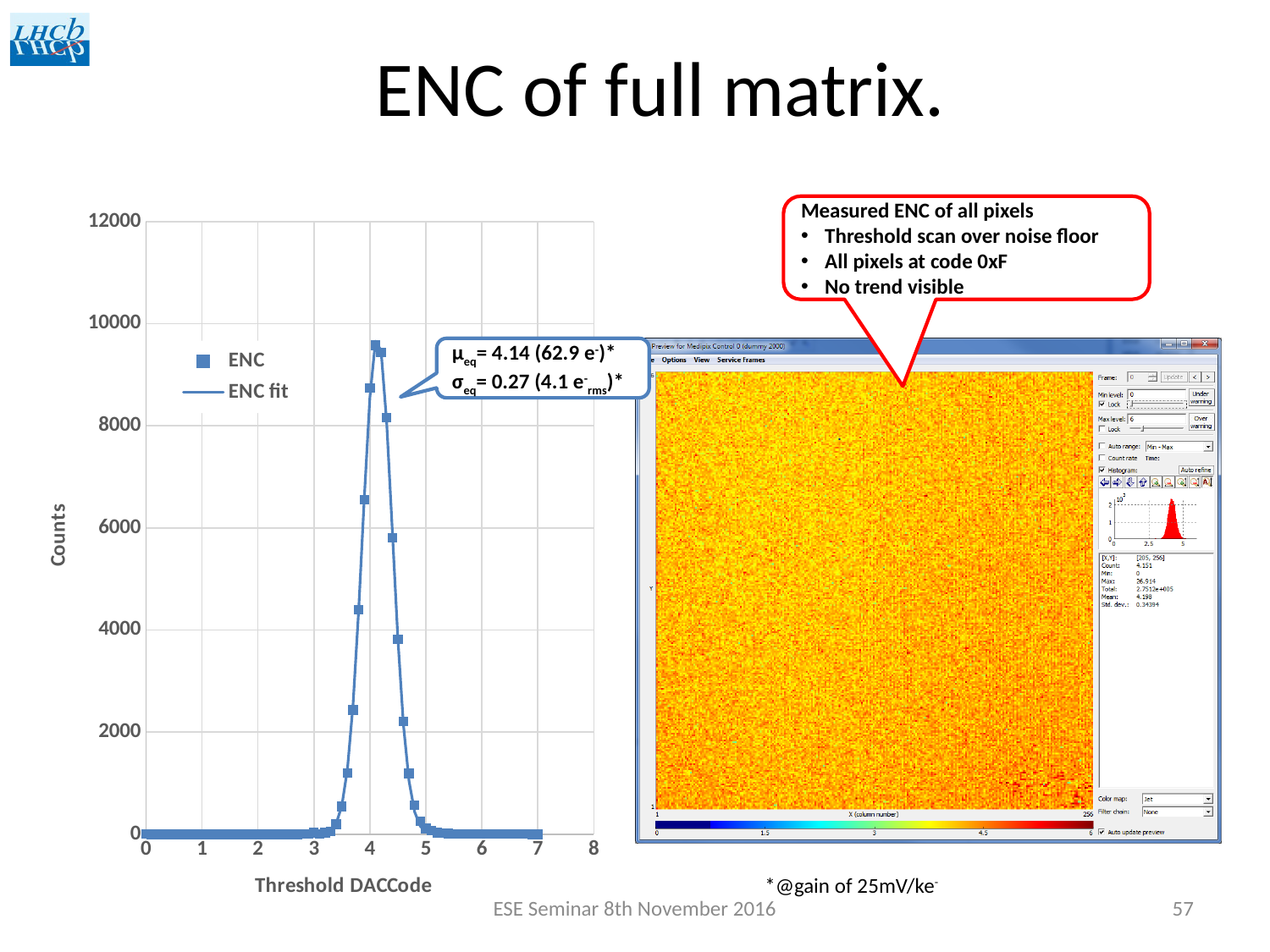
What are the two entries in the chart's legend? ENC and ENC fit Is the ENC count at Threshold DACCode 2 greater or less than 2000? less What is the title of the x axis of the chart? Threshold DACCode How many series does the legend of the chart list? 2 Is the ENC count at Threshold DACCode 6 greater or less than 2000? less Is the peak value of the ENC counts greater or less than 10000? less How do the ENC counts change as the Threshold DACCode increases from 3 to 5? They rise to a peak near 4 and then fall What is the highest tick value shown on the Counts axis of the chart? 12000 What kind of chart is shown on the left of the slide? Scatter chart with a fitted line